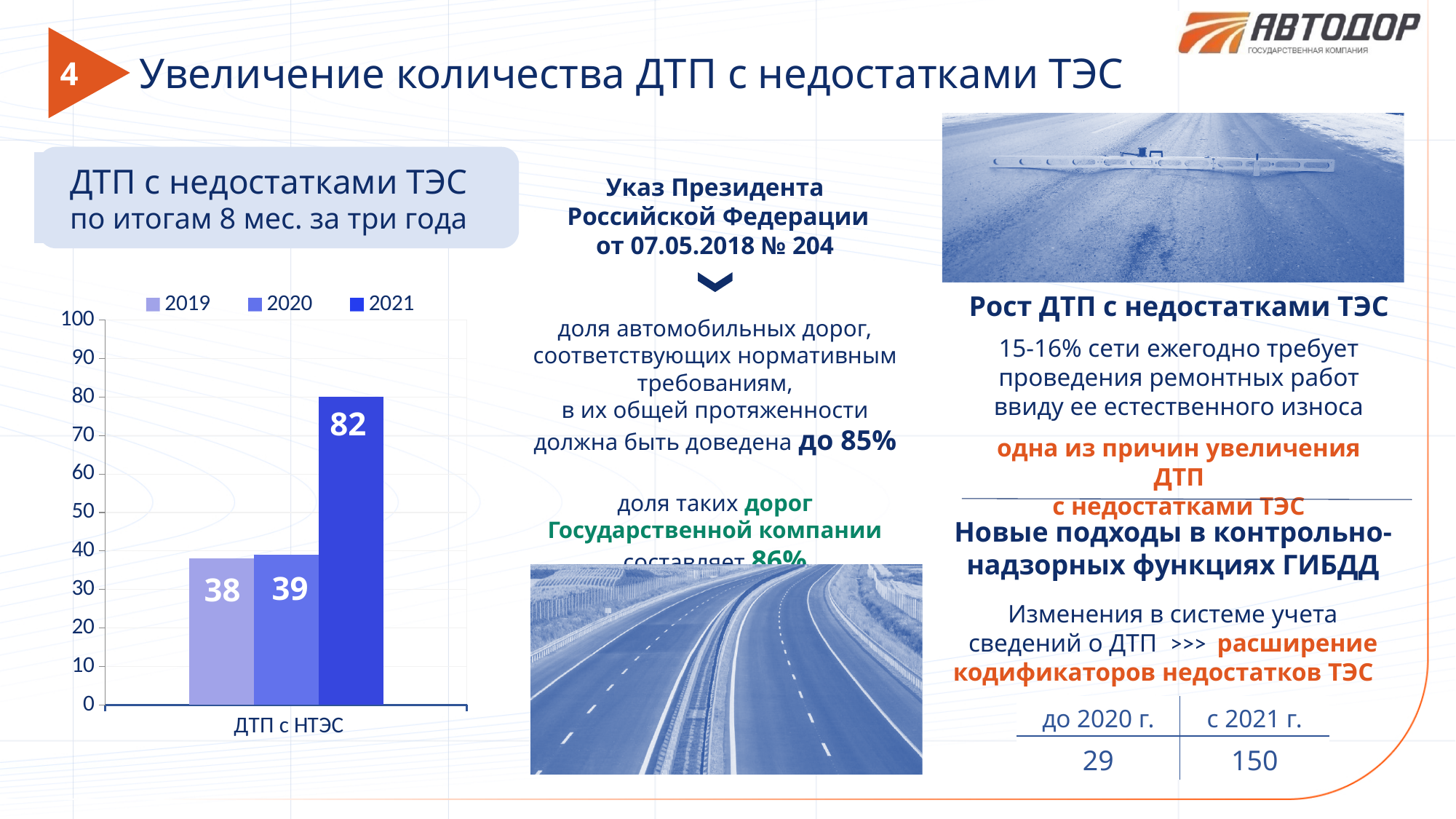
Which year has the highest value in the chart? 2021 How many series does the legend list? 3 Which is larger, the value for 2021 or the value for 2019? 2021 What is the value for 2020 in the chart? 39 What is the difference between the 2020 and 2019 values? 1 Is the value for 2021 greater or less than 70? greater Which year has the lowest value in the chart? 2019 What is the value for 2021 in the chart? 82 What kind of chart is shown on the slide? bar chart What is the value for 2019 in the chart? 38 What is the category label on the x axis of the chart? ДТП с НТЭС What is the difference between the 2021 and 2020 values? 43